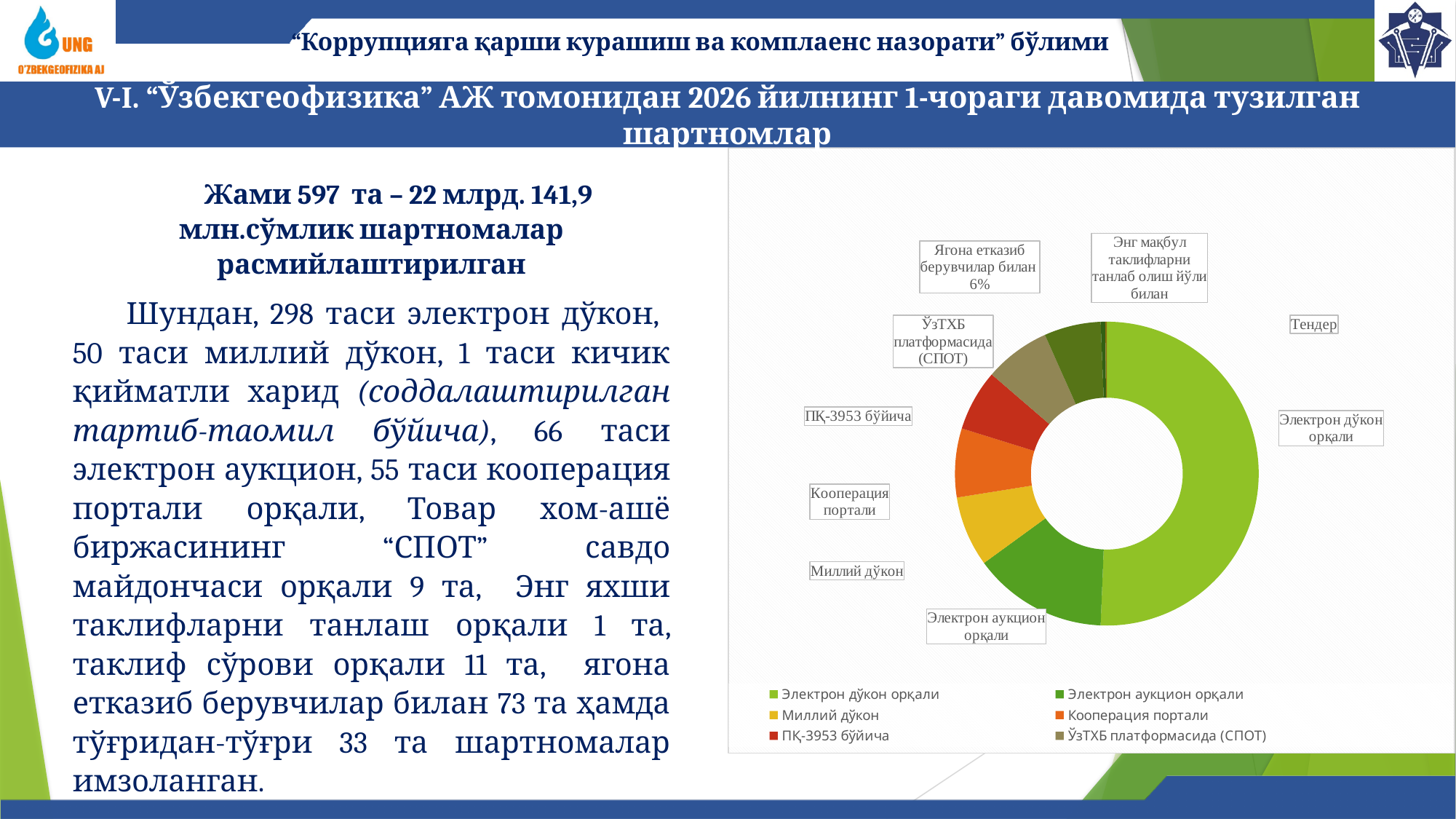
What kind of chart is shown on the slide? Pie (donut) chart Which slice is larger: "Электрон дўкон орқали" or "Миллий дўкон"? Электрон дўкон орқали What colour is the slice for "Электрон дўкон орқали"? Light green What share of the pie is labelled for "Ягона етказиб берувчилар билан"? 6% How many entries does the chart legend list? 6 Which category has the largest slice of the pie? Электрон дўкон орқали Which slice is larger: "Электрон аукцион орқали" or "Кооперация портали"? Электрон аукцион орқали Which slice is larger: "Электрон дўкон орқали" or "ПҚ-3953 бўйича"? Электрон дўкон орқали Which legend entry is shown in red? ПҚ-3953 бўйича